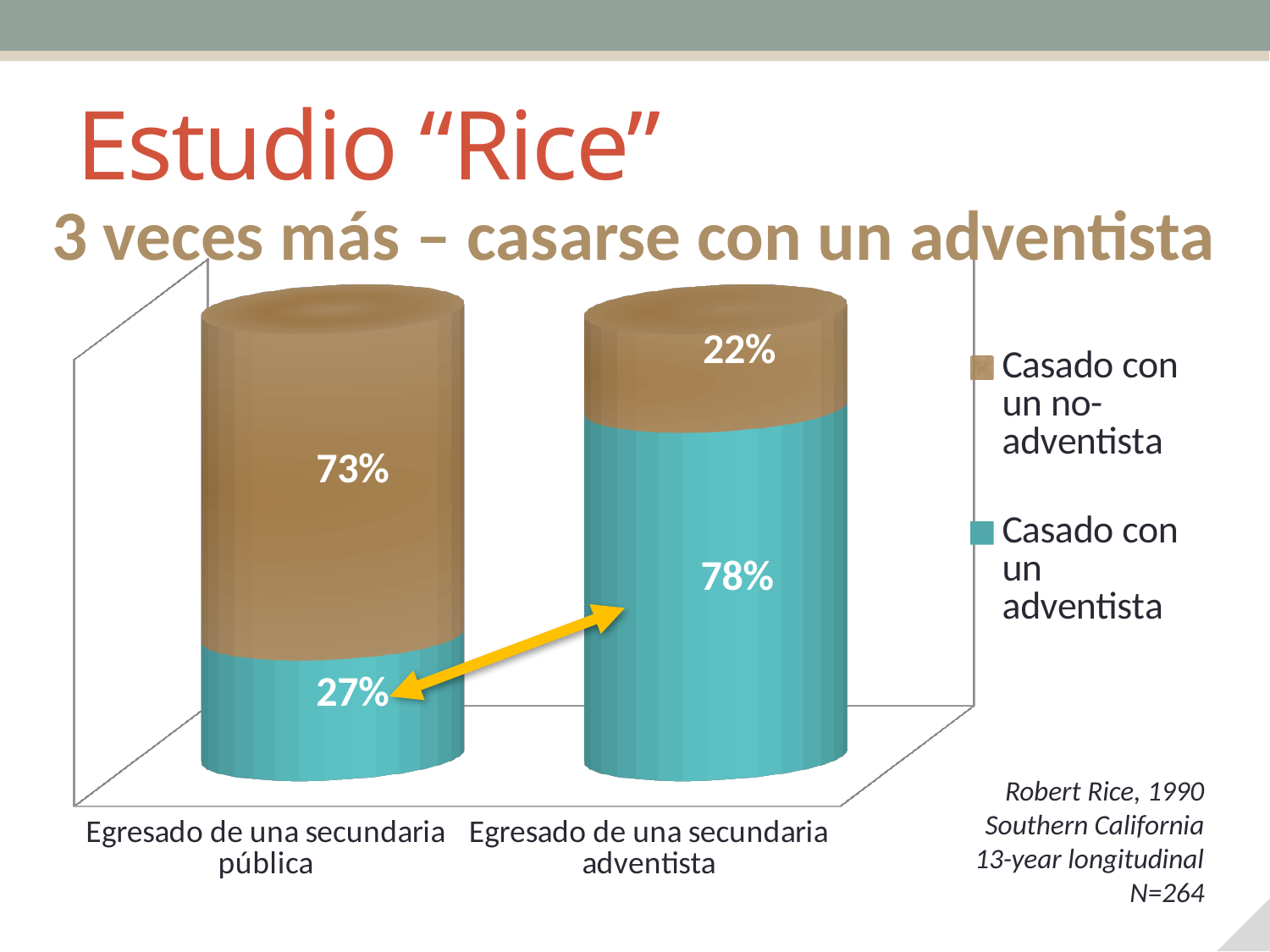
Which category has the lower value for 'Casado con un no-adventista'? Egresado de una secundaria adventista What percentage of graduates of an Adventist secondary school married a non-Adventist (Casado con un no-adventista)? 22% What percentage of graduates of a public secondary school married a non-Adventist (Casado con un no-adventista)? 73% Which legend entry is shown in teal (blue-green)? Casado con un adventista How many series does the chart legend list? 2 How many categories are shown on the x axis of the chart? 2 What percentage of graduates of an Adventist secondary school (Egresado de una secundaria adventista) married an Adventist (Casado con un adventista)? 78% What percentage of graduates of a public secondary school (Egresado de una secundaria pública) married an Adventist (Casado con un adventista)? 27% What kind of chart is shown on the slide? Stacked bar chart Which category has the higher value for 'Casado con un adventista'? Egresado de una secundaria adventista Is the 'Casado con un no-adventista' value larger for public school graduates or for Adventist school graduates? Egresado de una secundaria pública What is the difference between the 'Casado con un adventista' values for Adventist school graduates and public school graduates? 51 percentage points